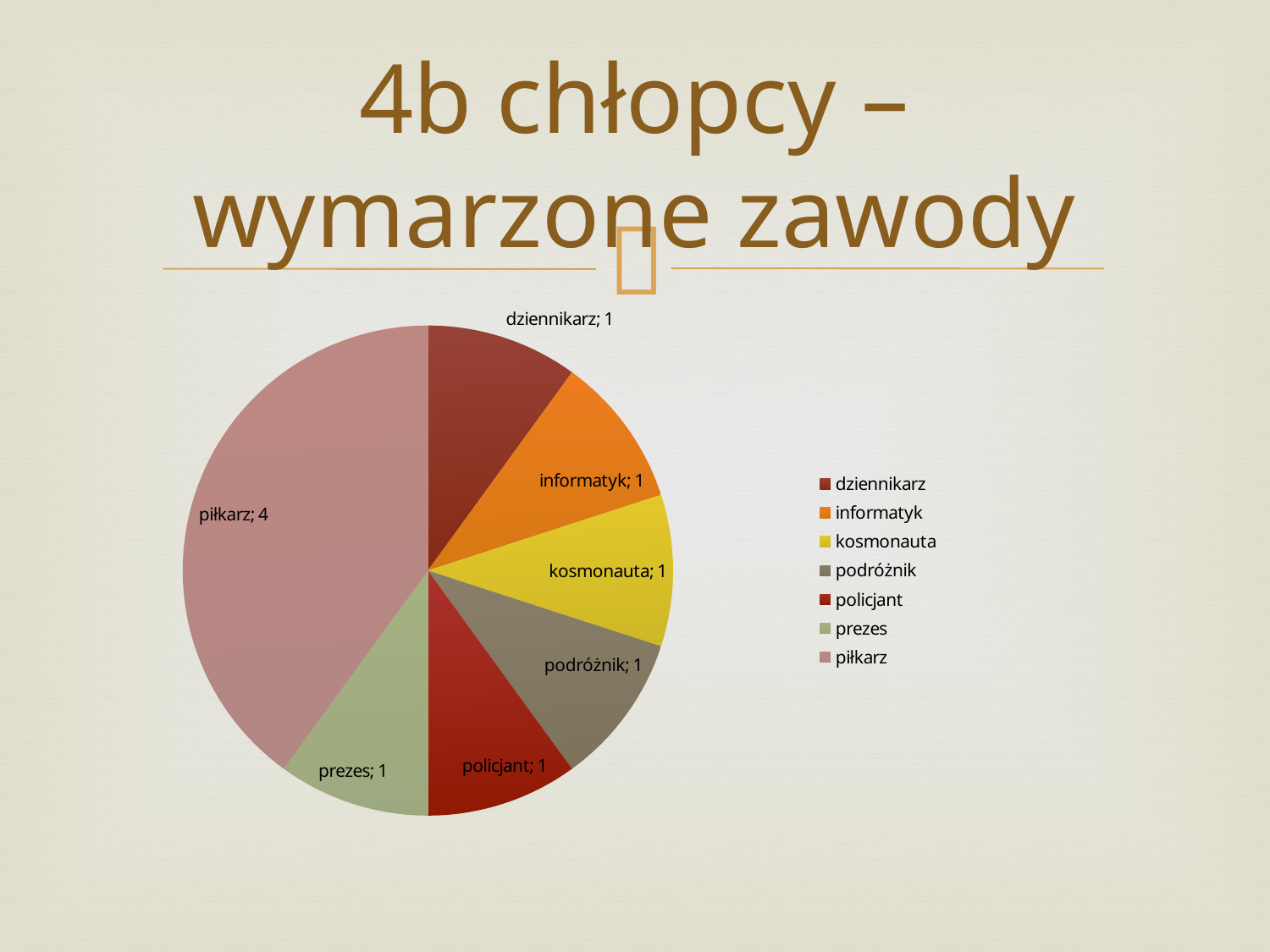
What share of the pie does dziennikarz represent? 10% Which category has the largest slice of the pie? piłkarz What is the value for piłkarz? 4 What type of chart is shown on the slide? pie chart What is the value for kosmonauta? 1 Which is larger, the value for piłkarz or the value for informatyk? piłkarz What is the difference between the values for piłkarz and policjant? 3 What share of the pie does piłkarz represent? 40% How many categories does the pie chart have? 7 What is the total of all the values in the pie chart? 10 What is the title of the slide containing the chart? 4b chłopcy – wymarzone zawody What is the value for podróżnik? 1